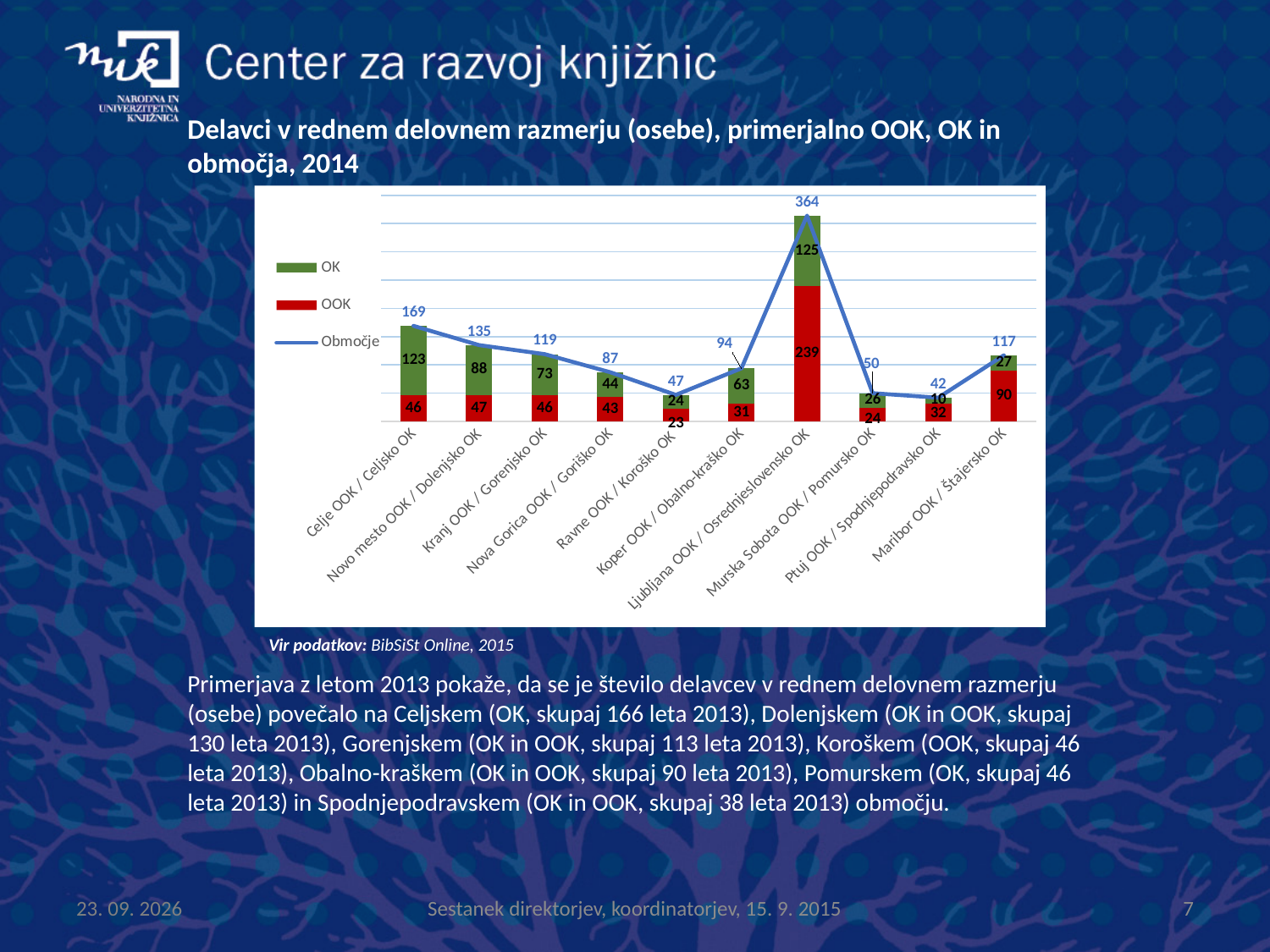
What is the total of the stacked bar for Ravne OOK / Koroško OK? 47 What is the OK value for Ptuj OOK / Spodnjepodravsko OK? 10 What is the difference between the OOK values for Maribor OOK / Štajersko OK and Koper OOK / Obalno-kraško OK? 59 Which category has the lowest Območje value? Ptuj OOK / Spodnjepodravsko OK What is the OK value for Celje OOK / Celjsko OK? 123 Which category has the highest Območje value? Ljubljana OOK / Osrednjeslovensko OK How many categories are shown on the x axis? 10 Which is larger, the OK value for Kranj OOK / Gorenjsko OK or the OK value for Novo mesto OOK / Dolenjsko OK? Novo mesto OOK / Dolenjsko OK What is the Območje value for Novo mesto OOK / Dolenjsko OK? 135 What is the OOK value for Ljubljana OOK / Osrednjeslovensko OK? 239 How many series does the legend list? 3 What kind of chart is this? Stacked bar chart with a line